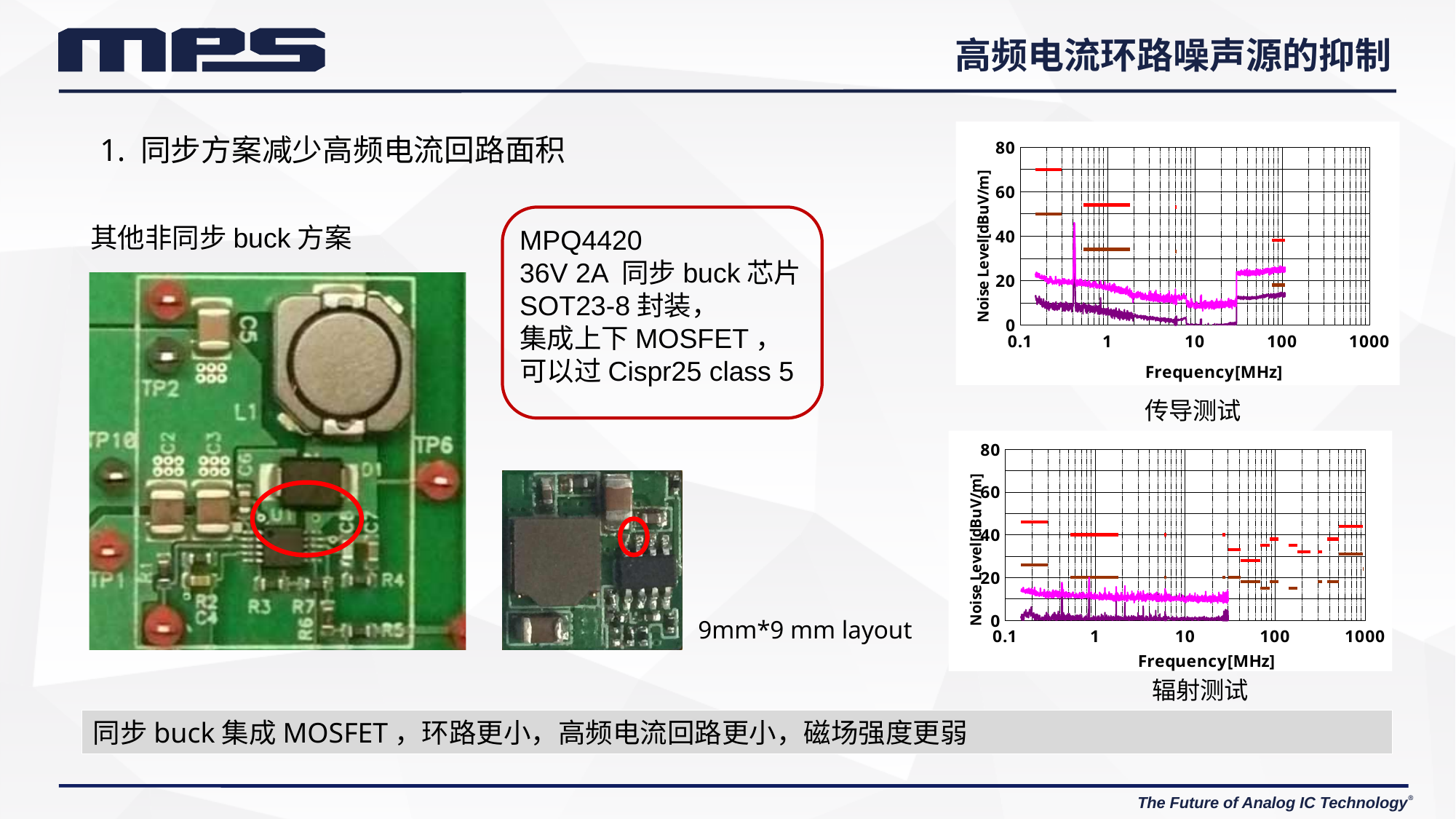
In the 辐射测试 chart, is the magenta trace at 1 MHz greater or less than 40? less In the 辐射测试 chart, what is the highest frequency tick shown on the x axis? 1000 In the 传导测试 chart, what is the highest value shown on the y axis? 80 In the 辐射测试 chart, what is the lowest frequency tick shown on the x axis? 0.1 What is the x-axis label of the 传导测试 chart? Frequency[MHz] How many charts are shown on the slide? 2 What kind of chart is the 辐射测试 chart on the right of the slide? line chart In the 传导测试 chart, is the purple trace at 1 MHz greater or less than 20? less In the 传导测试 chart, which trace is higher at 1 MHz, the magenta trace or the purple trace? magenta In the 传导测试 chart, is the magenta trace at 10 MHz greater or less than 20? less What is the y-axis label of the 辐射测试 chart? Noise Level[dBuV/m] What kind of chart is the 传导测试 chart on the right of the slide? line chart